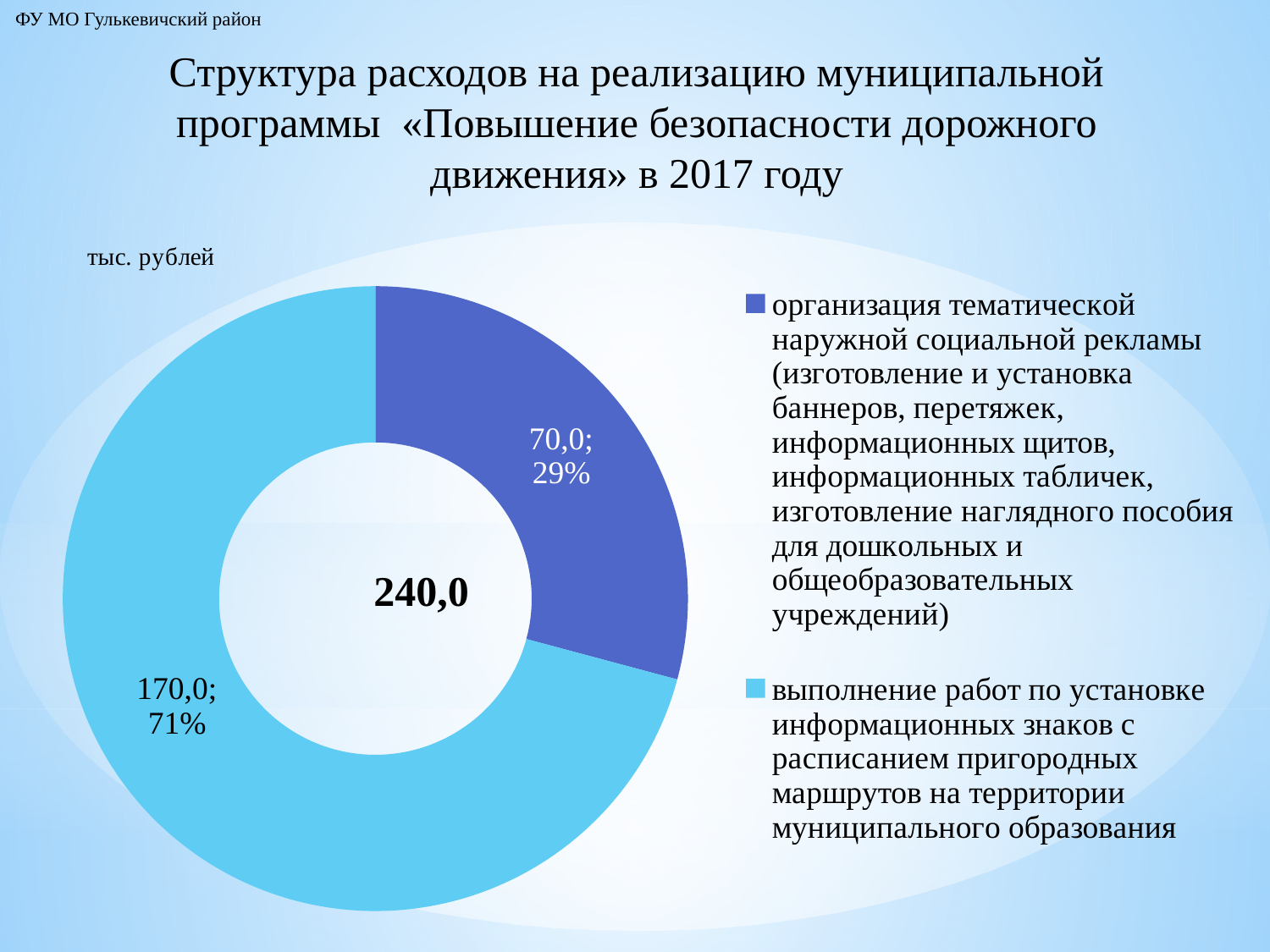
What unit is indicated for the chart values? тыс. рублей What is the difference between the value for "выполнение работ по установке информационных знаков" and the value for "организация тематической наружной социальной рекламы"? 100,0 Which category has the smallest value? организация тематической наружной социальной рекламы What share of the chart does "организация тематической наружной социальной рекламы" take? 29% How many categories does the chart show? 2 What is the value for "организация тематической наружной социальной рекламы"? 70,0 What share of the chart does "выполнение работ по установке информационных знаков" take? 71% Which category has the largest value? выполнение работ по установке информационных знаков с расписанием пригородных маршрутов на территории муниципального образования What is the value for "выполнение работ по установке информационных знаков с расписанием пригородных маршрутов на территории муниципального образования"? 170,0 What kind of chart is shown on the slide? Doughnut (pie) chart Which is larger: the value for "организация тематической наружной социальной рекламы" or the value for "выполнение работ по установке информационных знаков"? выполнение работ по установке информационных знаков What total is shown in the centre of the chart? 240,0